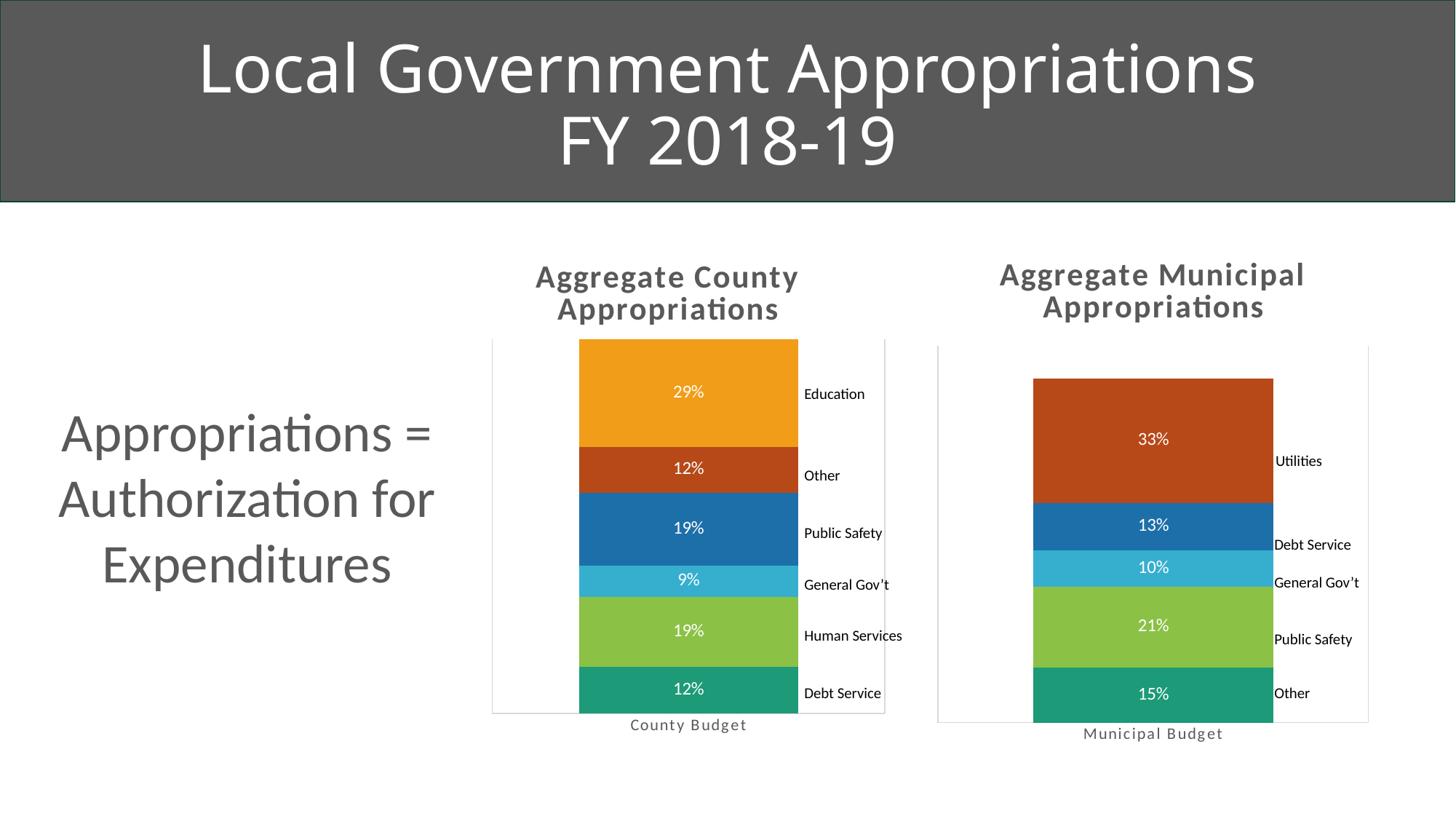
In the Aggregate County Appropriations chart, which category has the largest share? Education In the Aggregate Municipal Appropriations chart, what is the value for Public Safety? 21% In the Aggregate Municipal Appropriations chart, what share of the municipal budget goes to Utilities? 33% In the Aggregate Municipal Appropriations chart, what is the difference between the Utilities share and the Debt Service share? 20% In the Aggregate County Appropriations chart, which category has the smallest share? General Gov't In the Aggregate County Appropriations chart, what is the difference between Education and Debt Service? 17% In the Aggregate County Appropriations chart, what is the value for General Gov't? 9% In the Aggregate Municipal Appropriations chart, which category has the smallest share? General Gov't Which is larger: Public Safety in the Aggregate County Appropriations chart or Public Safety in the Aggregate Municipal Appropriations chart? Municipal (21%) In the Aggregate County Appropriations chart, what share of the county budget goes to Education? 29% What type of chart is the Aggregate Municipal Appropriations chart? Stacked bar chart How many segments make up the stacked bar in the Aggregate County Appropriations chart? 6